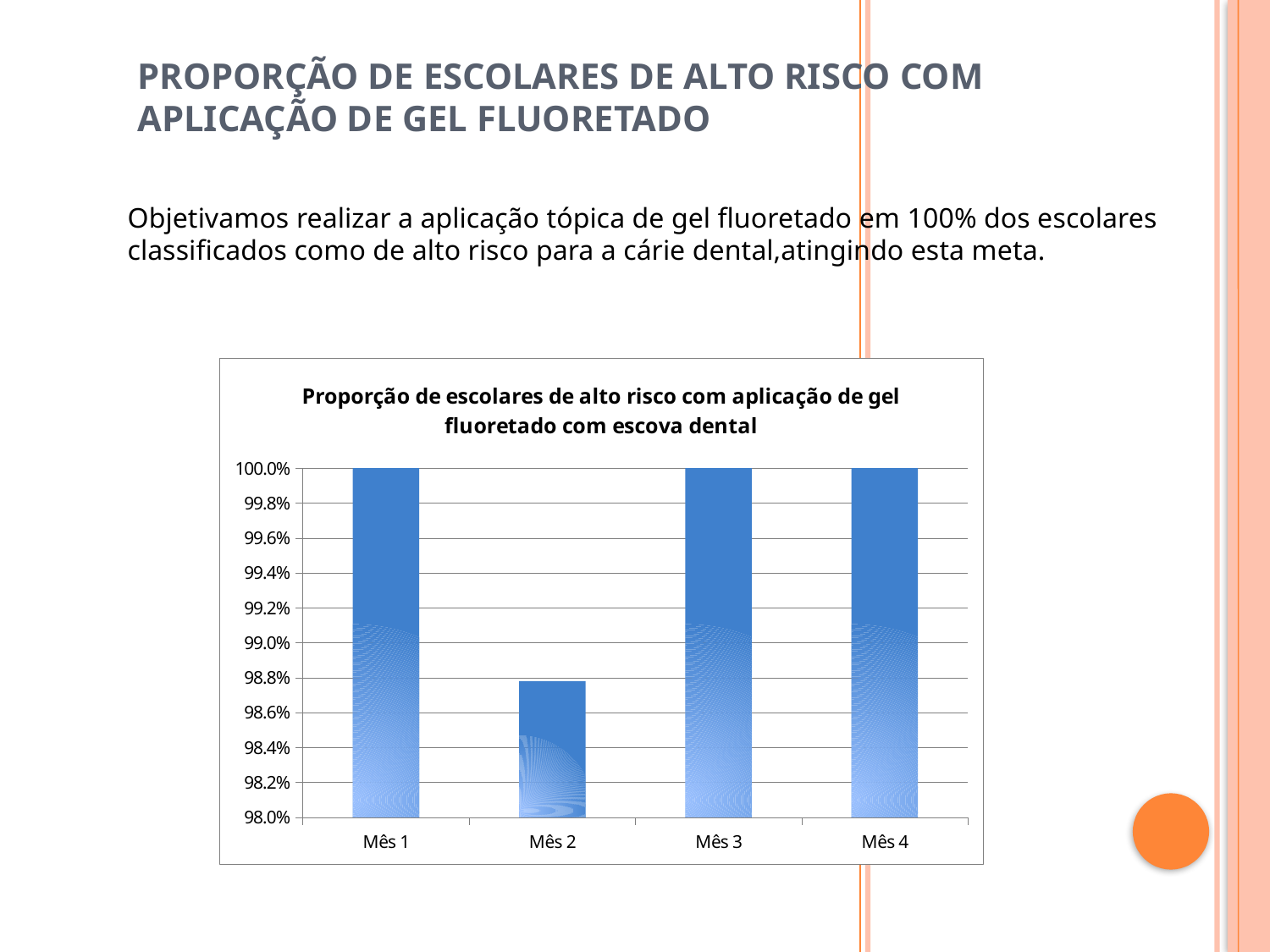
What is the value for Mês 4 in the chart? 100.0% What type of chart is shown on the slide? bar chart Is the value for Mês 2 greater or less than 98.6%? greater What is the value for Mês 1 in the chart? 100.0% What is the title of the chart? Proporção de escolares de alto risco com aplicação de gel fluoretado com escova dental How many categories (months) are shown on the x axis of the chart? 4 Does the value fall or rise from Mês 1 to Mês 2? fall What is the value for Mês 3 in the chart? 100.0% Which is larger, the value for Mês 1 or the value for Mês 2? Mês 1 What is the lowest value shown on the y axis of the chart? 98.0% Is the value for Mês 2 greater or less than 99.0%? less Which month has the lowest value in the chart? Mês 2